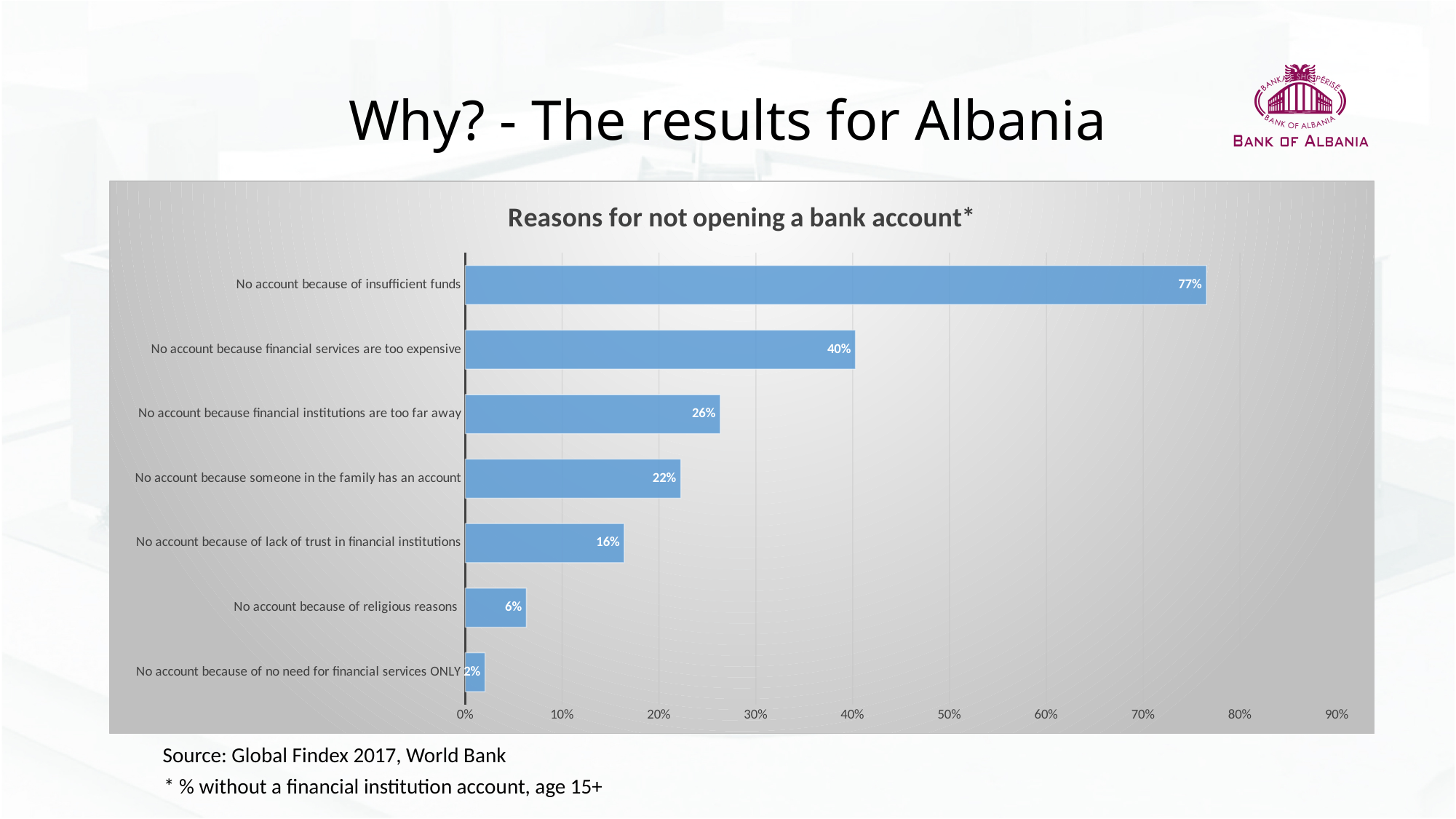
How many reasons (categories) are shown in the chart? 7 Which is larger: the value for 'financial institutions are too far away' or the value for 'someone in the family has an account'? No account because financial institutions are too far away What is the title of the chart? Reasons for not opening a bank account* Which reason has the lowest percentage in the chart? No account because of no need for financial services ONLY What is the difference between the percentage for insufficient funds and the percentage for financial services being too expensive? 37% What is the value for 'No account because of religious reasons'? 6% What percentage of respondents cited insufficient funds as a reason for not opening a bank account? 77% What is the source cited for the chart data? Global Findex 2017, World Bank What is the value for 'No account because of lack of trust in financial institutions'? 16% What is the value for 'No account because financial services are too expensive'? 40% Which reason has the highest percentage in the chart? No account because of insufficient funds What type of chart is shown on the slide? Bar chart